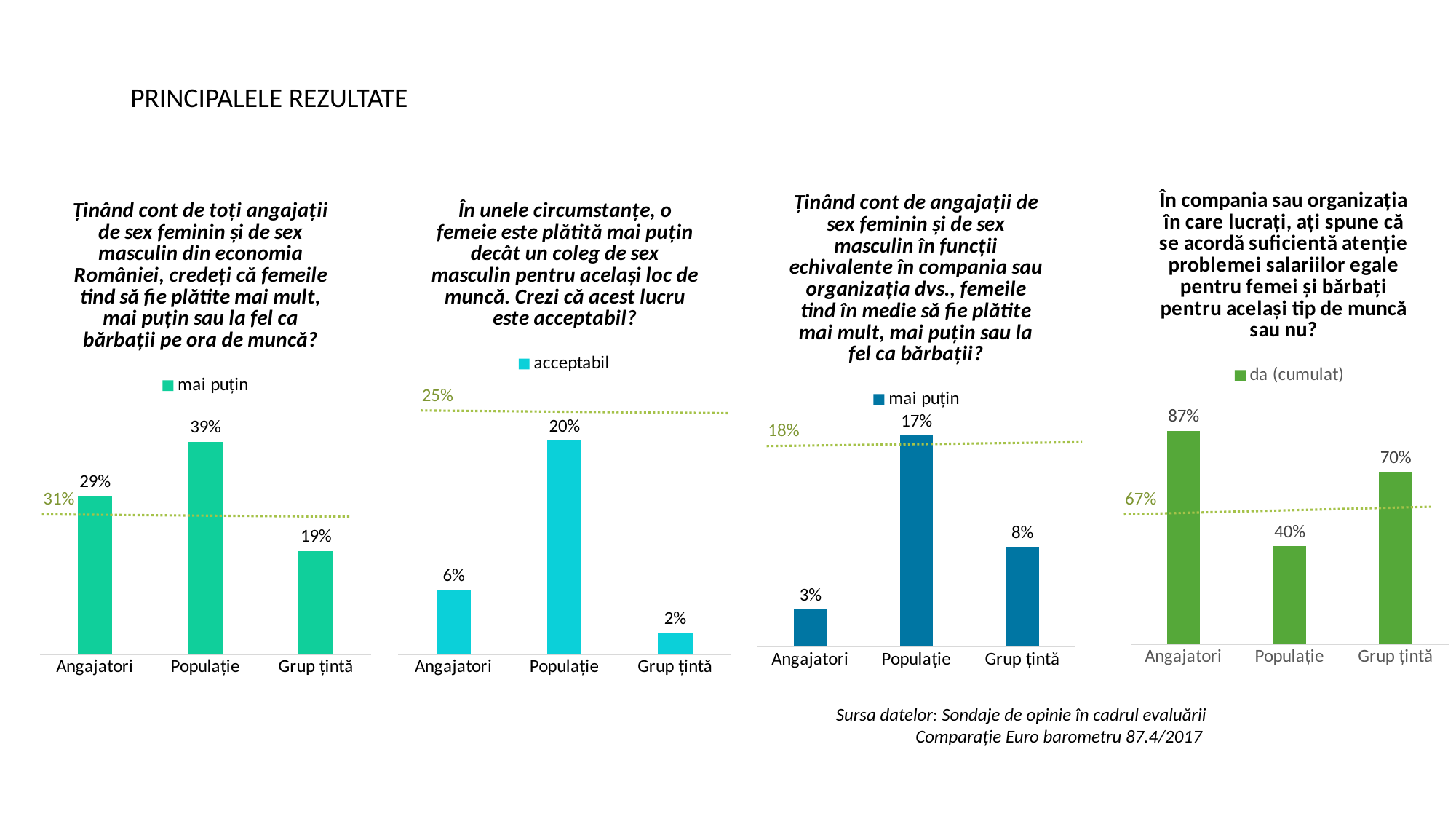
In the rightmost chart (legend 'da (cumulat)'), what is the difference between the values for Grup țintă and Populație? 30% In the second chart from the left (legend 'acceptabil'), what is the value for Grup țintă? 2% What kind of chart is the leftmost chart? Bar chart In the rightmost chart (legend 'da (cumulat)'), what is the value for Angajatori? 87% In the leftmost chart, what is the difference between the values for Populație and Angajatori? 10% How many categories are shown on the x axis of the rightmost chart? 3 In the third chart from the left (dark blue bars), which is larger, the value for Populație or the value for Angajatori? Populație In the second chart from the left (legend 'acceptabil'), what is the value for Angajatori? 6% In the second chart from the left (legend 'acceptabil'), which category has the highest value? Populație In the leftmost chart, what is the value for Populație? 39% In the third chart from the left (dark blue bars), what is the value for Grup țintă? 8% In the leftmost chart, which category has the lowest value? Grup țintă